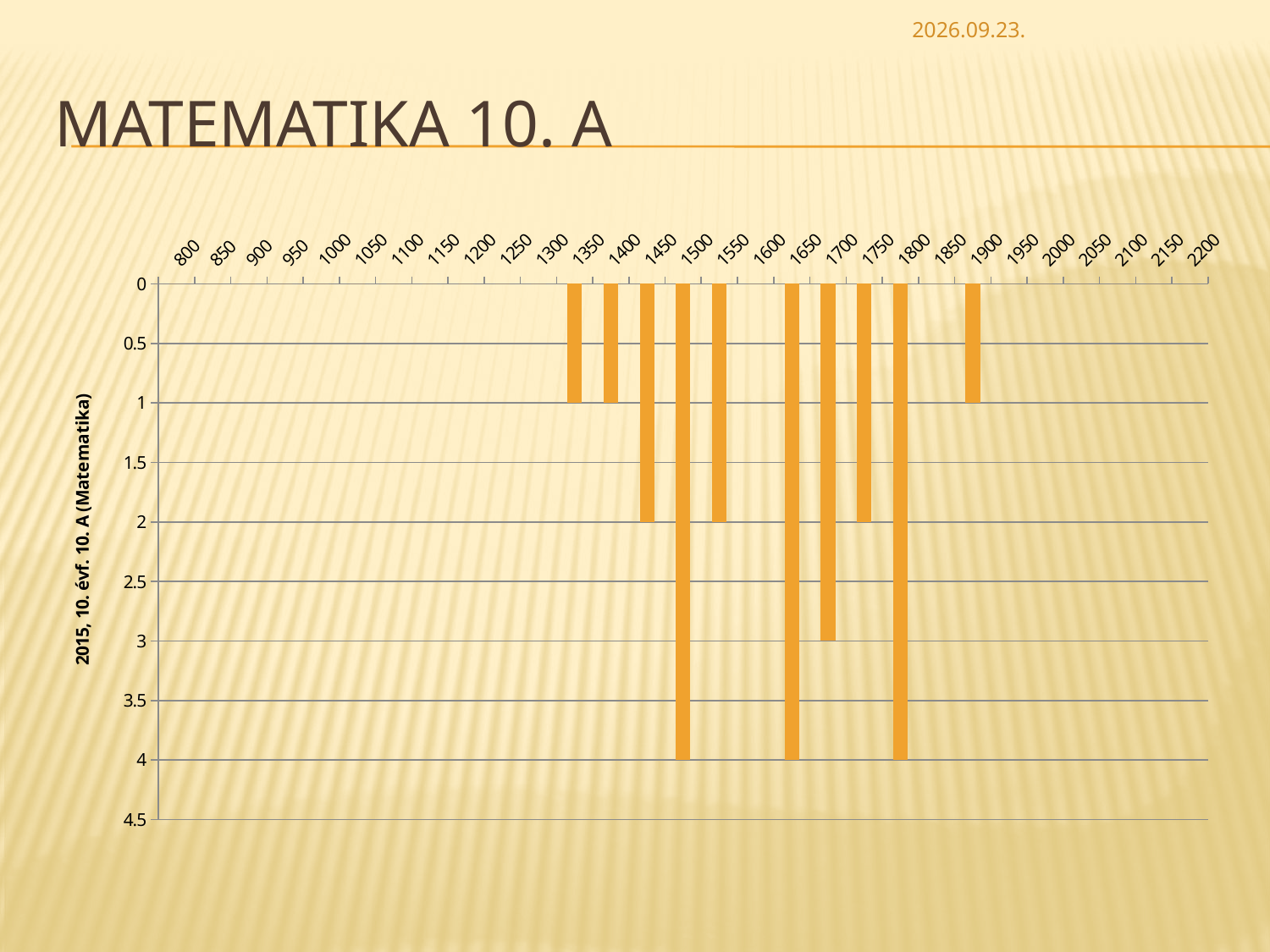
How many bars reach the value 4? 3 What is the title of the slide containing the chart? MATEMATIKA 10. A What value does the bar between the 1650 and 1700 ticks reach? 3 What is the difference between the bar between 1650 and 1700 and the bar between 1700 and 1750? 1 What is the largest value reached by any bar in the chart? 4 What is the smallest value reached by any bar in the chart? 1 What kind of chart is shown on the slide? bar chart How many bars are plotted in the chart? 10 What is the label on the vertical axis of the chart? 2015, 10. évf. 10. A (Matematika) Which is larger: the bar between 1450 and 1500 or the bar between 1500 and 1550? the bar between 1450 and 1500 What value does the bar between the 1400 and 1450 ticks reach? 2 What value does the bar between the 1850 and 1900 ticks reach? 1